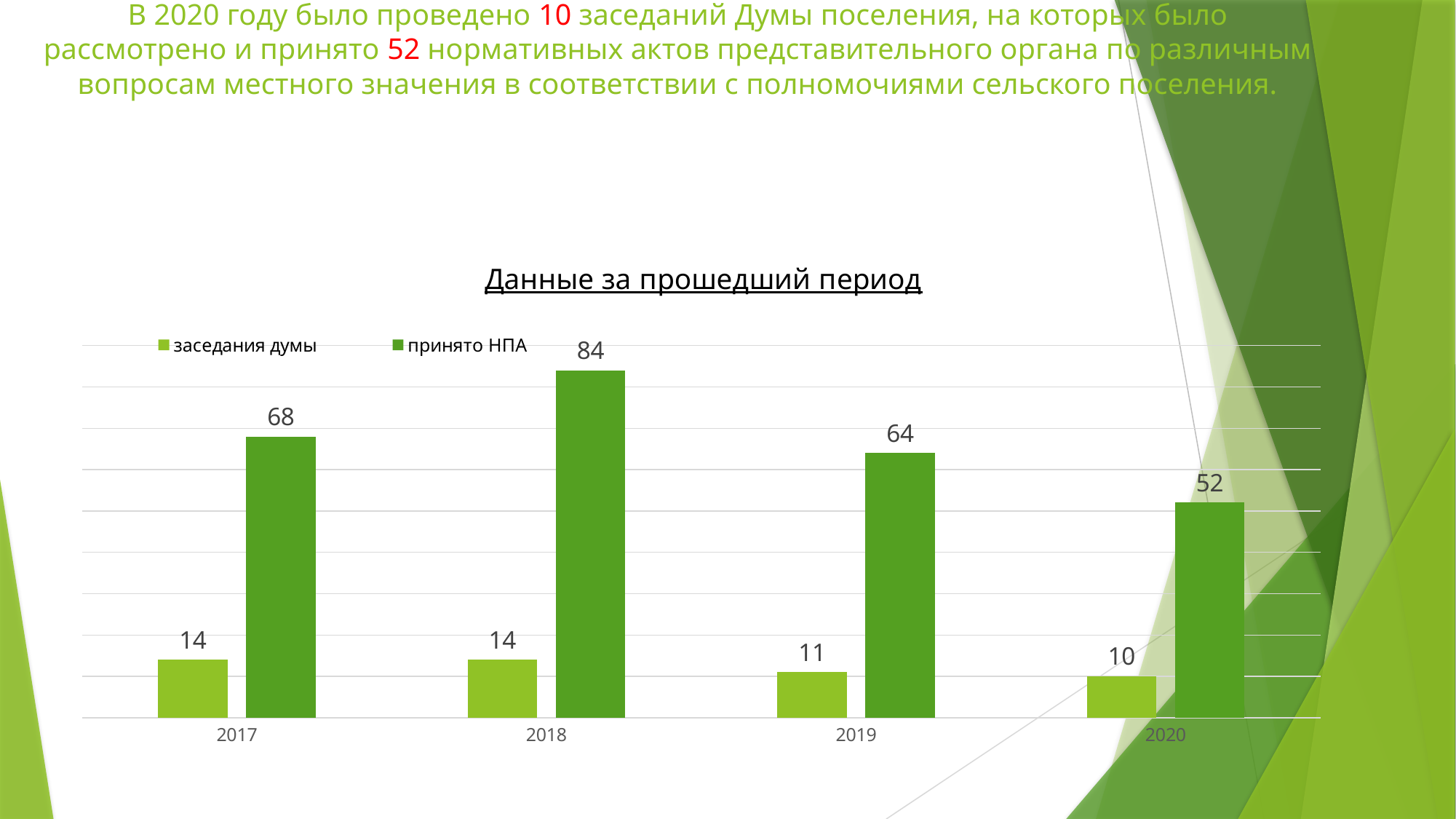
In which year is the value for "заседания думы" lowest? 2020 Which is larger: "принято НПА" in 2017 or in 2019? 2017 What kind of chart is shown? bar chart In which year is the value for "принято НПА" highest? 2018 What is the value for "принято НПА" in 2020? 52 What is the title of the chart? Данные за прошедший период How many series does the legend list? 2 How many years are shown on the x axis? 4 What is the value for "принято НПА" in 2018? 84 What is the difference between the "принято НПА" values for 2018 and 2020? 32 What is the value for "заседания думы" in 2019? 11 Does the value for "принято НПА" rise or fall from 2018 to 2020? fall